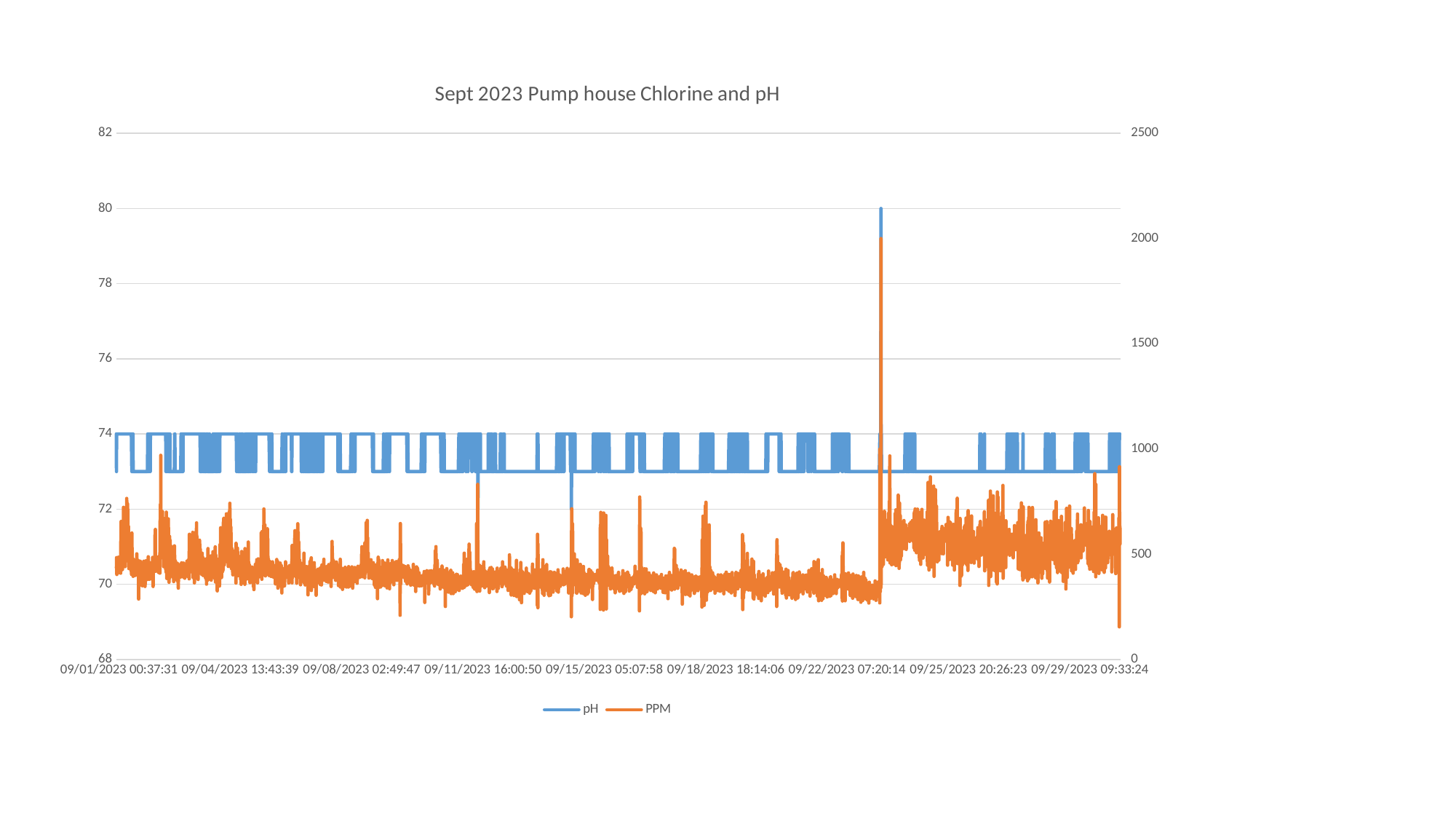
Is the PPM value on 09/18/2023 greater or less than 1000? less Is the peak pH value at the large spike near 09/22/2023 greater or less than 78? greater What is the highest tick value shown on the left vertical axis? 82 Is the peak PPM value at the large spike near 09/22/2023 greater or less than 1500? greater What is the highest tick value shown on the right vertical axis? 2500 What is the first date-time label on the x axis? 09/01/2023 00:37:31 How many series does the legend list? 2 What kind of chart is shown on the slide? line chart Does the general PPM level after the spike near 09/22/2023 sit higher or lower than before it? higher